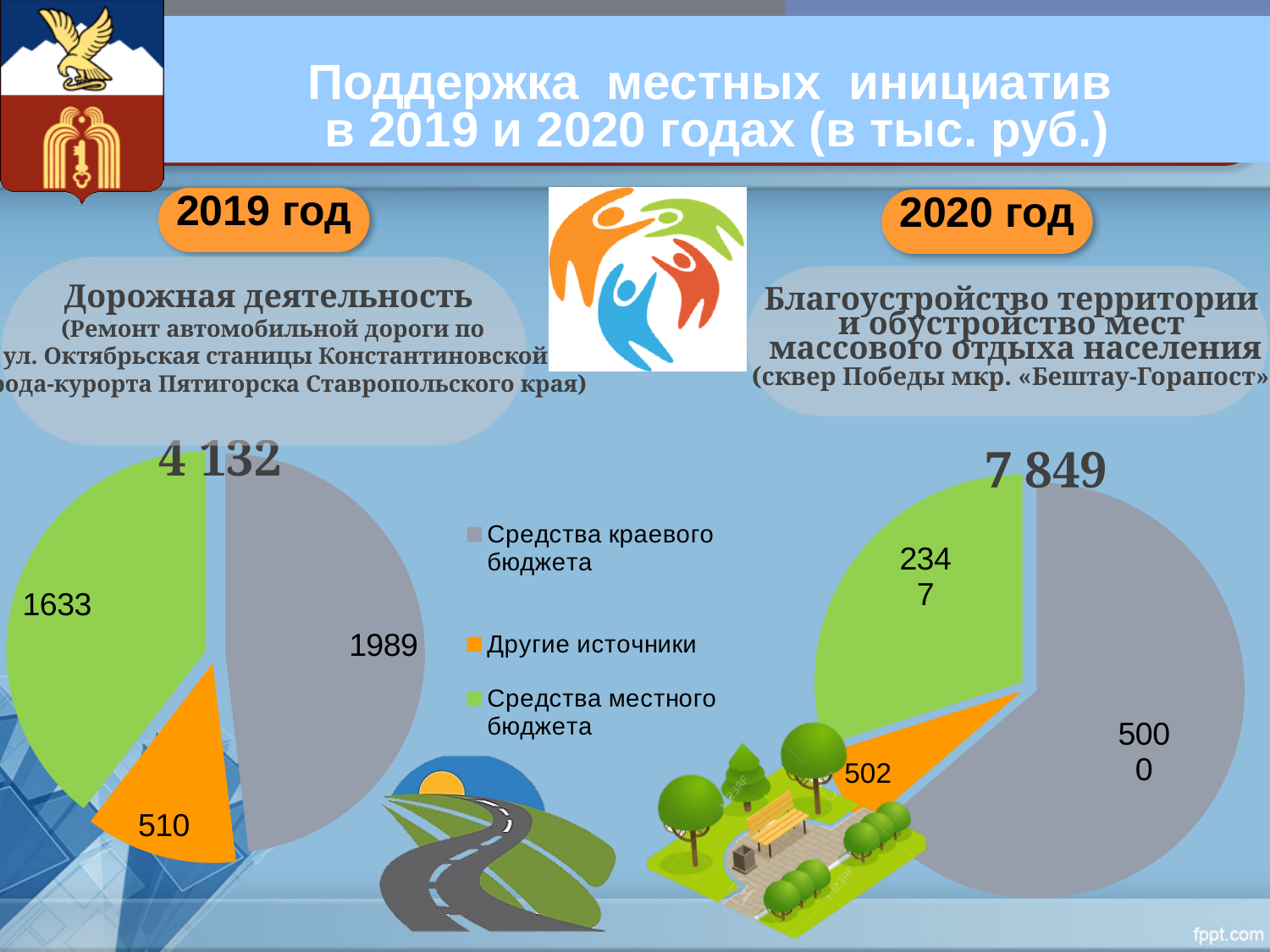
In the 2020 год chart, which source has the largest slice? Средства краевого бюджета How many entries does the legend between the two charts list? 3 What kind of chart is used for the 2019 год data on the left? pie chart In the 2019 год chart, which source has the smallest slice? Другие источники In the 2019 год chart, what is the value for Средства краевого бюджета? 1989 What total is shown above the 2020 год pie chart? 7 849 In the 2020 год chart, what is the value for Средства местного бюджета? 2347 How many slices does the 2019 год pie chart have? 3 In the 2019 год chart, what is the value for Другие источники? 510 In the 2019 год chart, how much larger is Средства краевого бюджета than Средства местного бюджета? 356 In the 2020 год chart, what is the value for Средства краевого бюджета? 5000 In the 2020 год chart, which is larger: Средства краевого бюджета or Средства местного бюджета? Средства краевого бюджета